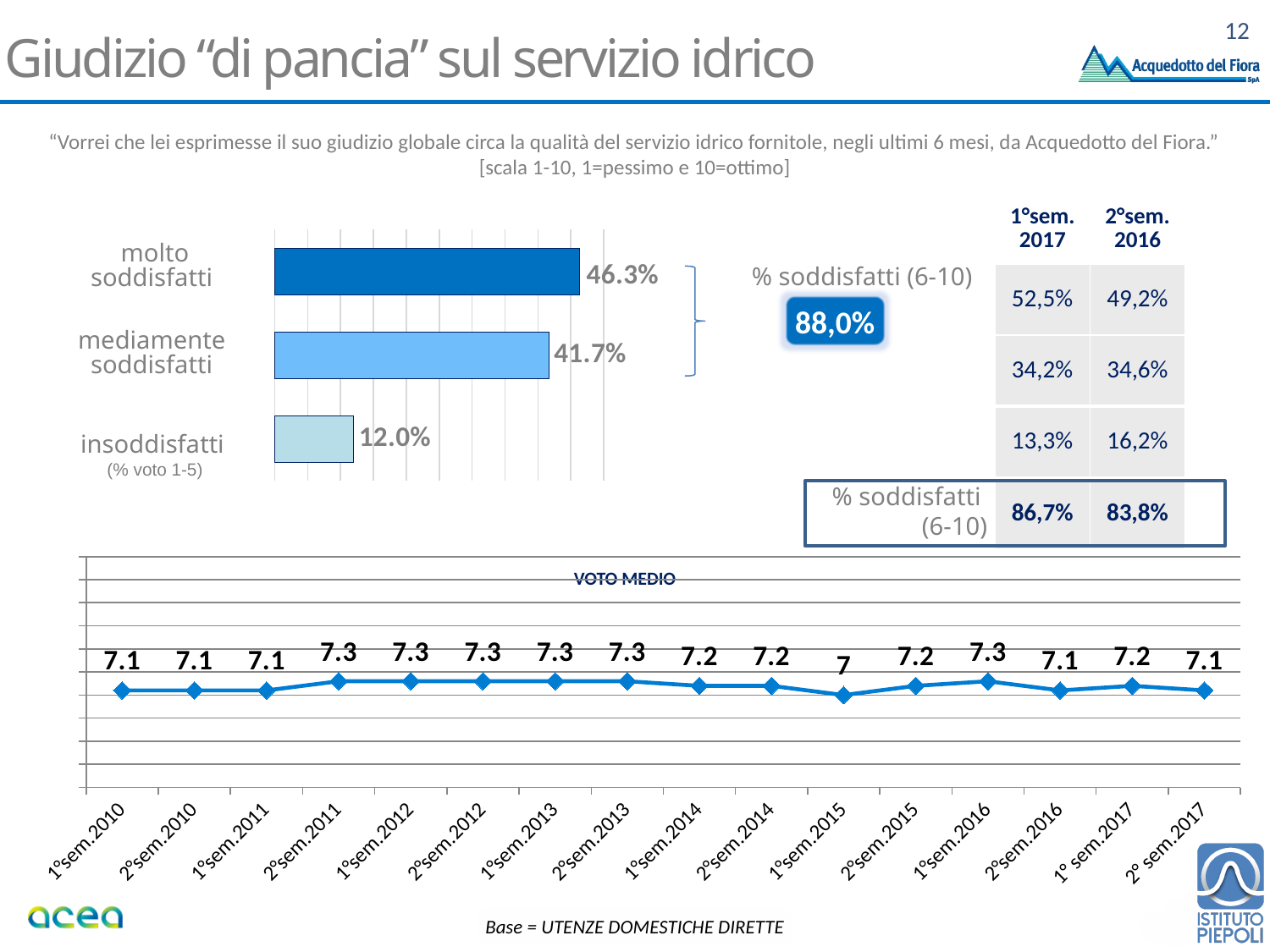
In the bar chart at the top of the slide, what is the difference between "molto soddisfatti" and "mediamente soddisfatti"? 4.6% In the bar chart at the top of the slide, what is the value for "molto soddisfatti"? 46.3% In the "VOTO MEDIO" chart, what is the value for 1°sem.2015? 7 What kind of chart is the chart at the top of the slide? bar chart In the bar chart at the top of the slide, which category has the lowest value? insoddisfatti What kind of chart is the "VOTO MEDIO" chart? line chart In the bar chart at the top of the slide, how many categories are shown? 3 In the bar chart at the top of the slide, what is the value for "insoddisfatti"? 12.0% In the "VOTO MEDIO" chart, how many data points are plotted? 16 In the "VOTO MEDIO" chart, what is the value for 2°sem.2011? 7.3 In the "VOTO MEDIO" chart, what is the value for 2° sem.2017? 7.1 In the "VOTO MEDIO" chart, which period has the lowest value? 1°sem.2015